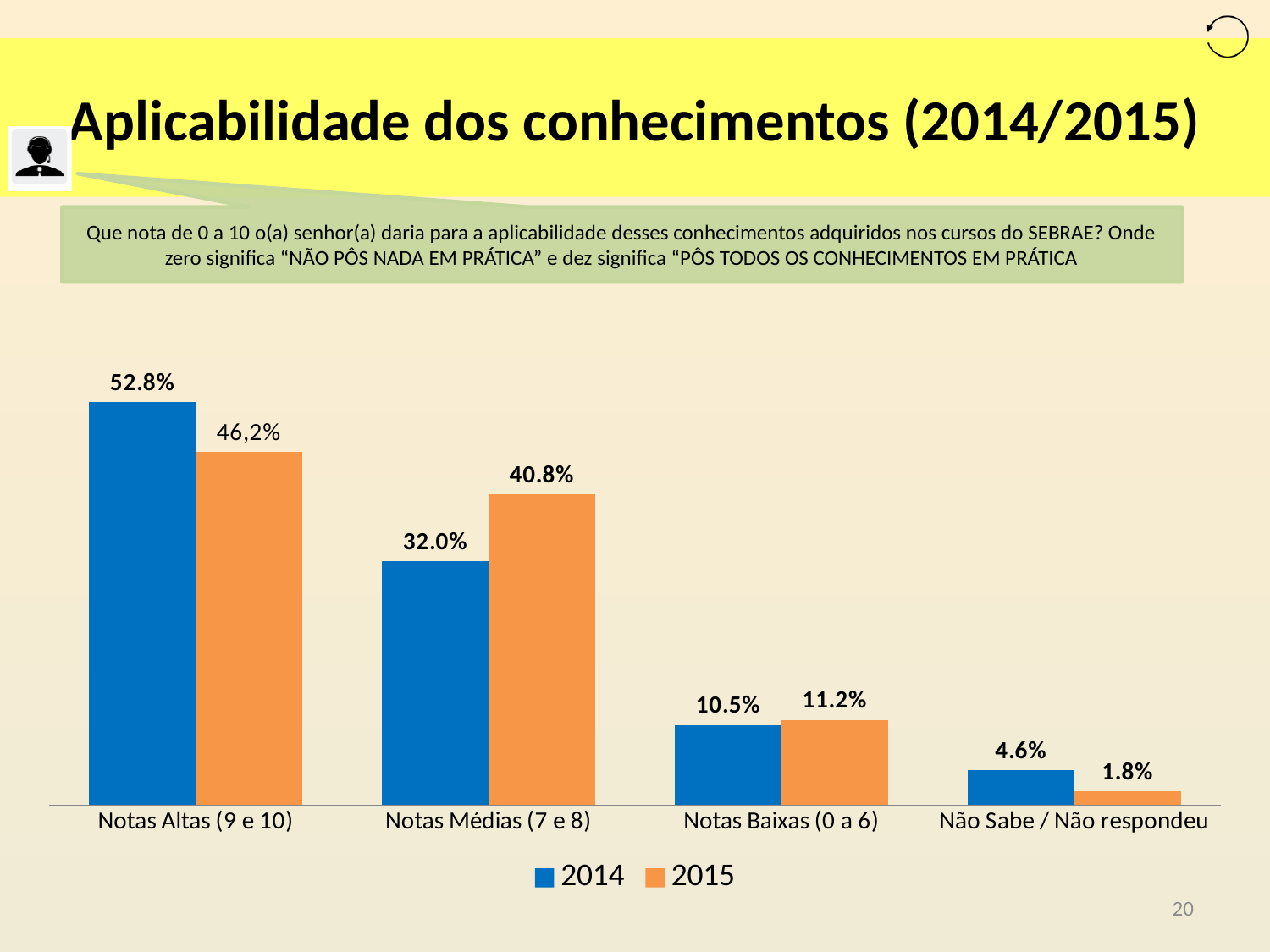
What is the 2015 value for Notas Médias (7 e 8)? 40.8% What is the 2014 value for Não Sabe / Não respondeu? 4.6% Which category has the highest 2014 value? Notas Altas (9 e 10) What is the difference between the 2015 and 2014 values for Notas Médias (7 e 8)? 8.8 percentage points Which colour represents the 2015 series in the chart? Orange How many series does the legend list? 2 For Notas Baixas (0 a 6), which year has the larger value, 2014 or 2015? 2015 What is the 2014 value for Notas Altas (9 e 10)? 52.8% What kind of chart is shown on the slide? Bar chart What is the 2015 value for Notas Altas (9 e 10)? 46,2% How many categories are shown on the x axis? 4 Which category has the lowest 2015 value? Não Sabe / Não respondeu